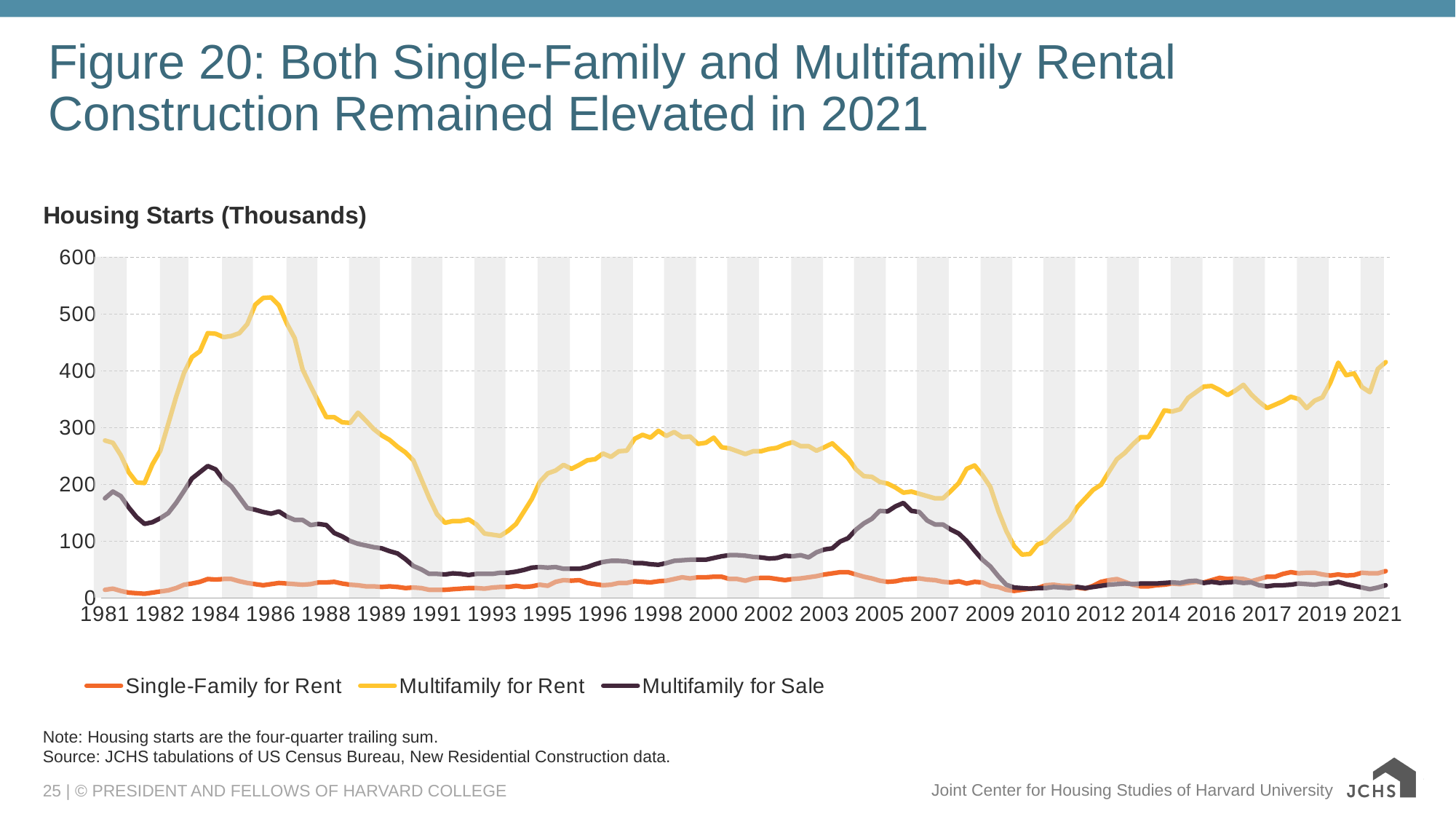
What is the label above the y axis of the chart? Housing Starts (Thousands) Is the value for Multifamily for Sale in 2006 greater or less than 100? greater Does the Multifamily for Sale line rise or fall between 2006 and 2010? fall Is the value for Multifamily for Rent in 1986 greater or less than 500? greater What kind of chart is shown on the slide? line chart What are the three series named in the legend? Single-Family for Rent, Multifamily for Rent, Multifamily for Sale How many series does the legend list? 3 In 2021, which series is higher: Single-Family for Rent or Multifamily for Sale? Single-Family for Rent In 2021, which series is higher: Multifamily for Rent or Multifamily for Sale? Multifamily for Rent Which series reaches the highest value anywhere on the chart? Multifamily for Rent Is the value for Multifamily for Rent in 2010 greater or less than 100? less